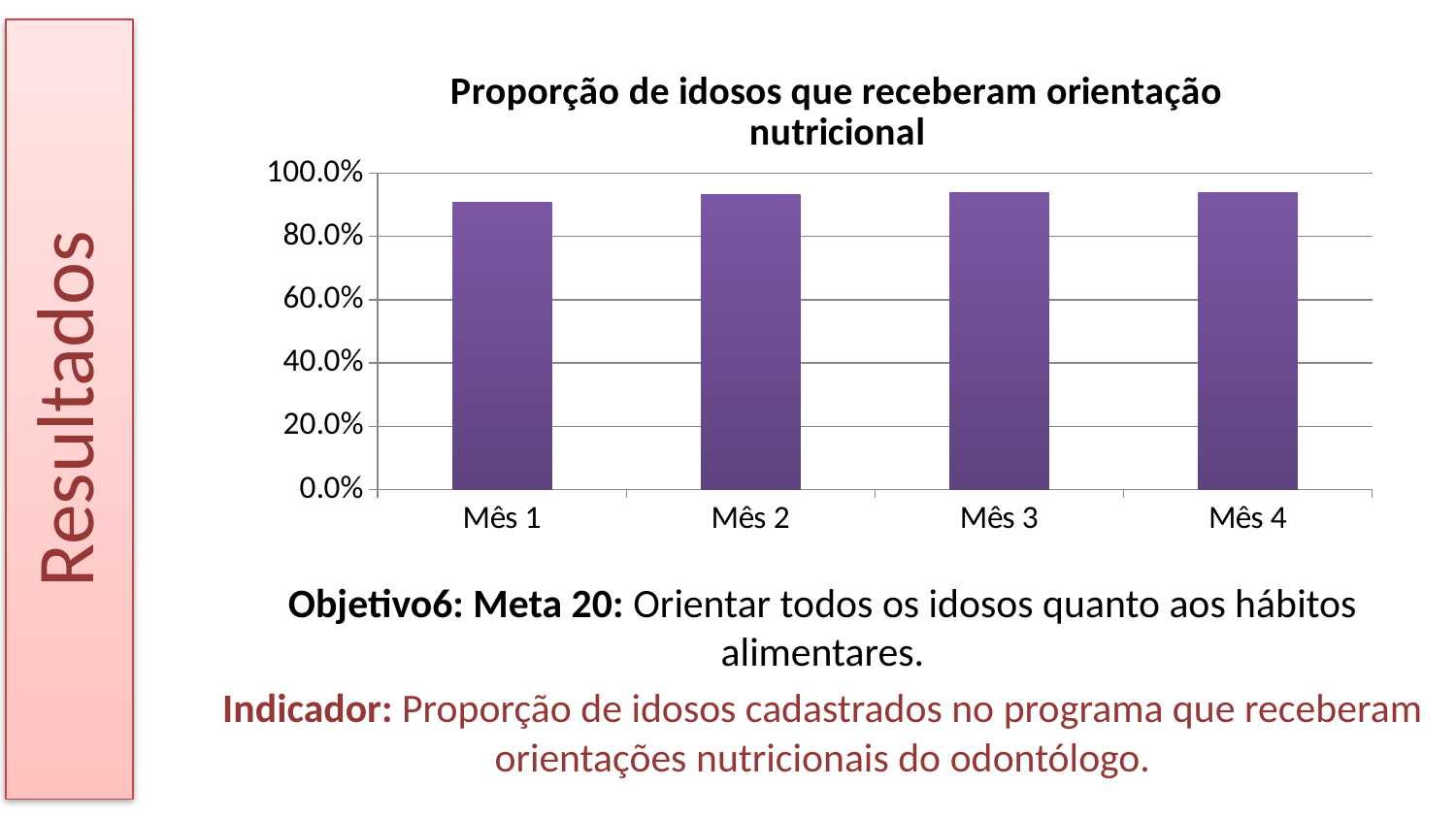
Is the value for Mês 2 greater or less than 60.0%? greater Which is larger, the value for Mês 1 or the value for Mês 4? Mês 4 Is the value for Mês 4 greater or less than 80.0%? greater What is the highest value shown on the y axis? 100.0% What kind of chart is shown on the slide? bar chart Which month has the lowest proportion of elderly who received nutritional guidance? Mês 1 What is the title of the chart? Proporção de idosos que receberam orientação nutricional How many categories (months) are plotted on the chart? 4 Is the value for Mês 1 greater or less than 80.0%? greater Which is larger, the value for Mês 1 or the value for Mês 3? Mês 3 What is the label of the first category on the x axis? Mês 1